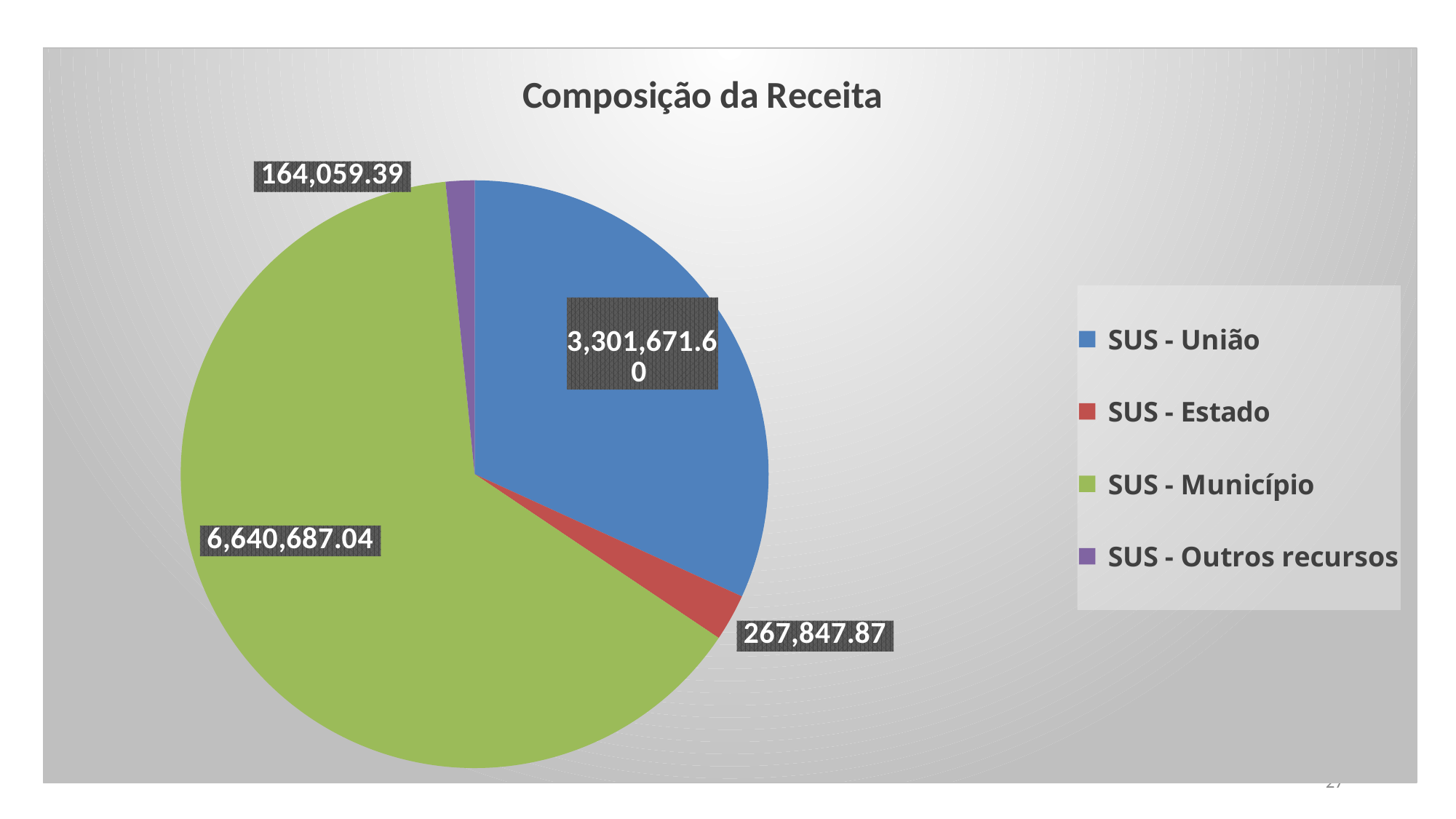
Which category has the smallest slice of the pie? SUS - Outros recursos What is the value for SUS - Outros recursos? 164,059.39 What is the value for SUS - União? 3,301,671.60 What kind of chart is shown on the slide? Pie chart What is the value for SUS - Estado? 267,847.87 Which category has the largest slice of the pie? SUS - Município What is the value for SUS - Município? 6,640,687.04 What is the title of the chart? Composição da Receita What is the difference between the values for SUS - Município and SUS - União? 3,339,015.44 How many slices does the pie chart have? 4 What is the difference between the values for SUS - Estado and SUS - Outros recursos? 103,788.48 Which is larger, the value for SUS - Estado or the value for SUS - Outros recursos? SUS - Estado